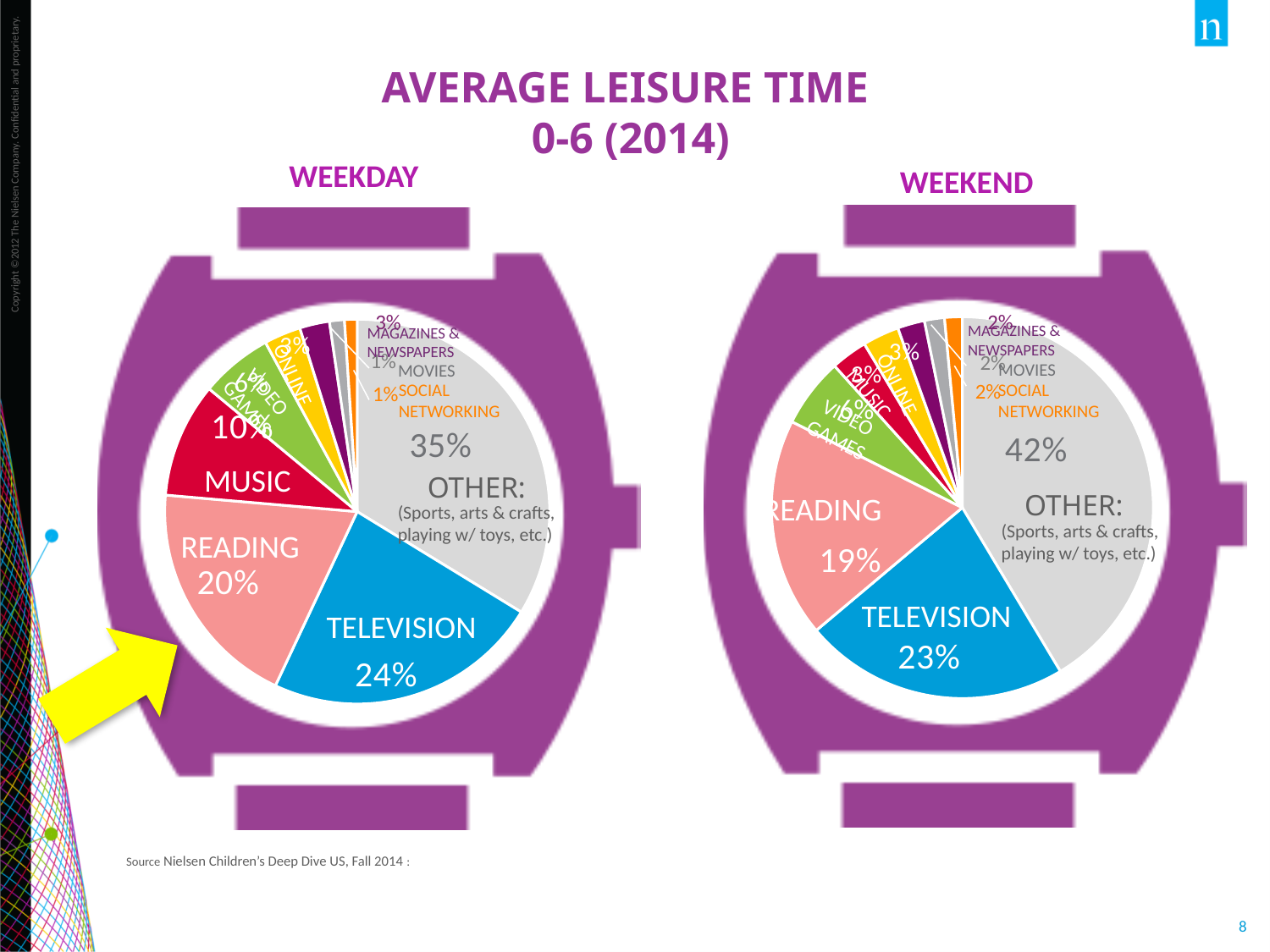
In the WEEKDAY pie chart, what percentage is TELEVISION? 24% In the WEEKDAY pie chart, what is the difference between the TELEVISION and READING percentages? 4 percentage points Is the TELEVISION share larger in the WEEKDAY chart or the WEEKEND chart? WEEKDAY In the WEEKEND pie chart, what percentage is MAGAZINES & NEWSPAPERS? 2% In the WEEKEND pie chart, what percentage is READING? 19% In the WEEKDAY pie chart, which category has the largest slice? OTHER In the WEEKEND pie chart, what share of leisure time is OTHER? 42% In the WEEKEND pie chart, which category has the largest slice? OTHER What type of chart is used to show the WEEKDAY and WEEKEND leisure time? Pie chart In the WEEKDAY pie chart, what percentage is MUSIC? 10% How much larger is the OTHER share in the WEEKEND chart than in the WEEKDAY chart? 7 percentage points In the WEEKDAY pie chart, what share of leisure time is OTHER? 35%